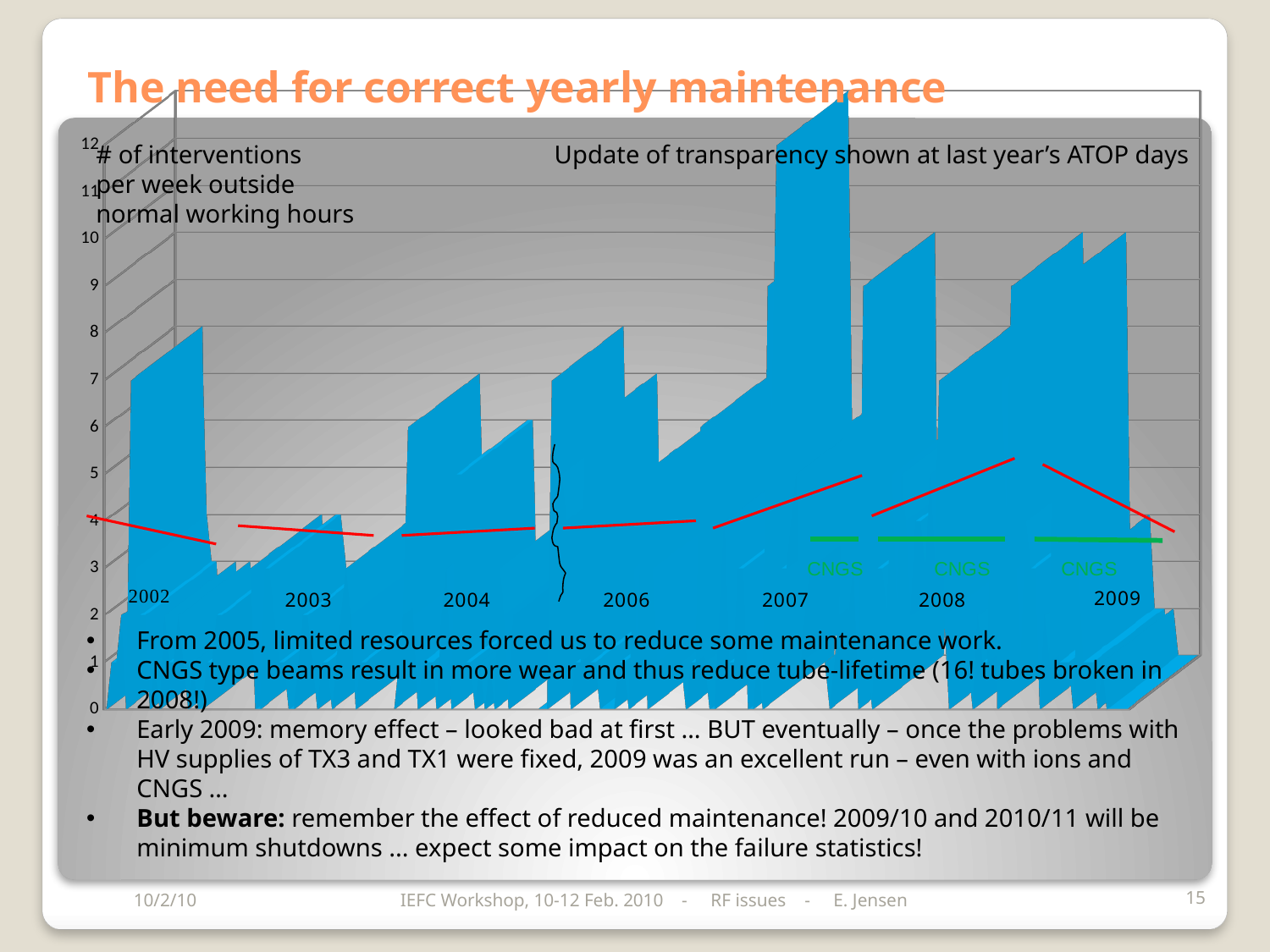
In which year does the chart reach its highest peak? 2007 Which year is skipped between 2004 and 2006 on the x axis? 2005 Is the highest peak in 2007 greater or less than 10? greater Is the highest peak in 2002 greater or less than 6? greater Does the red trend line rise or fall between 2008 and 2009? fall What quantity does the chart plot, according to the label in its top-left corner? # of interventions per week outside normal working hours How many year labels appear along the x axis of the chart? 7 Is the highest peak in 2003 greater or less than 6? less How many years are marked with a green CNGS label on the chart? 3 What is the highest value shown on the y axis of the chart? 12 Which year has the lowest peak on the chart, 2003 or 2007? 2003 What kind of chart is shown on the slide? area chart